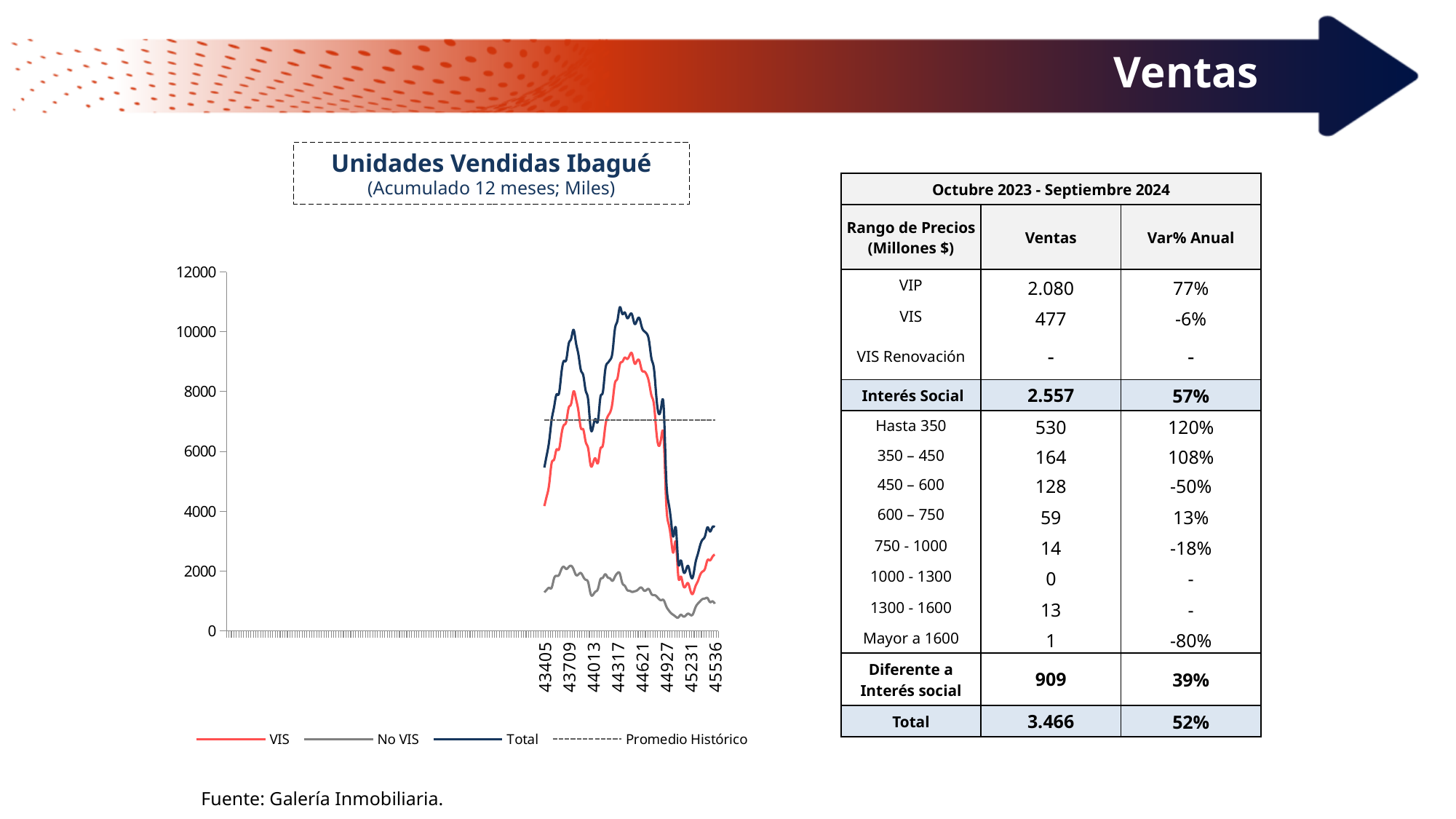
In the 'Unidades Vendidas Ibagué' chart, is the VIS value at the x-axis label 45536 greater or less than 4000? less In the 'Unidades Vendidas Ibagué' chart, is the Promedio Histórico line greater or less than 6000? greater In the 'Unidades Vendidas Ibagué' chart, is the highest value reached by the Total series greater or less than 10000? greater In the 'Unidades Vendidas Ibagué' chart, which series reaches the highest value? Total In the 'Unidades Vendidas Ibagué' chart, which series is drawn as a dashed line? Promedio Histórico In the 'Unidades Vendidas Ibagué' chart, does the Total series rise or fall between the x-axis labels 44621 and 45231? fall What kind of chart is 'Unidades Vendidas Ibagué'? Line chart How many series does the legend of the 'Unidades Vendidas Ibagué' chart list? 4 In the 'Unidades Vendidas Ibagué' chart, which series has the lowest values throughout? No VIS In the 'Unidades Vendidas Ibagué' chart, which series is higher at the x-axis label 44317, VIS or No VIS? VIS What is the subtitle shown under the chart title 'Unidades Vendidas Ibagué'? (Acumulado 12 meses; Miles)